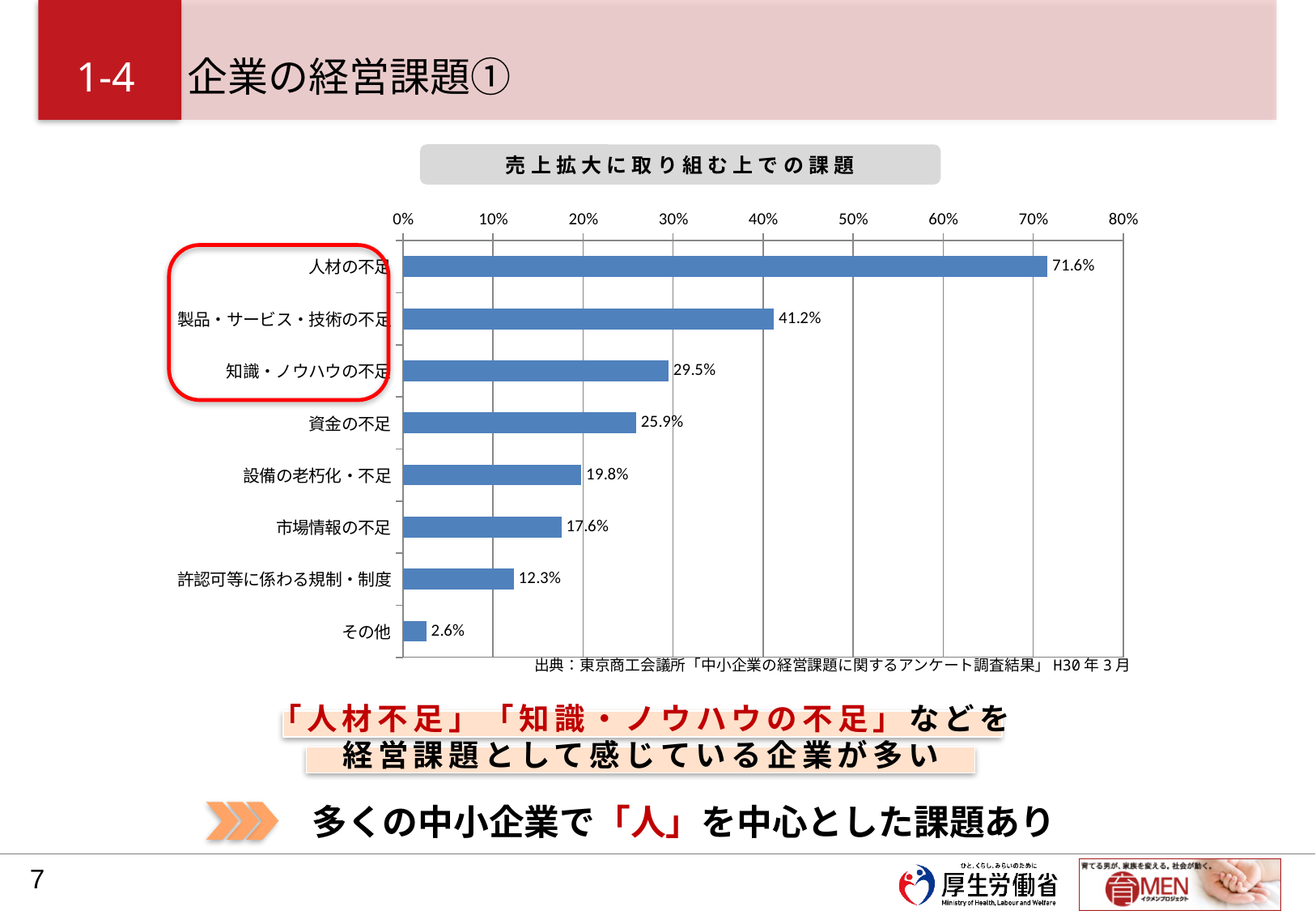
How many categories are shown in the chart? 8 Which is larger, the value for 設備の老朽化・不足 or 市場情報の不足? 設備の老朽化・不足 What is the difference between the values for 人材の不足 and 製品・サービス・技術の不足? 30.4% Which category has the lowest value? その他 What is the value for 許認可等に係わる規制・制度? 12.3% What is the value for 製品・サービス・技術の不足? 41.2% What kind of chart is shown on the slide? bar chart What is the value for 人材の不足? 71.6% Which category has the highest value? 人材の不足 What is the title of the chart? 売上拡大に取り組む上での課題 What is the value for 資金の不足? 25.9% What is the difference between the values for 知識・ノウハウの不足 and 資金の不足? 3.6%